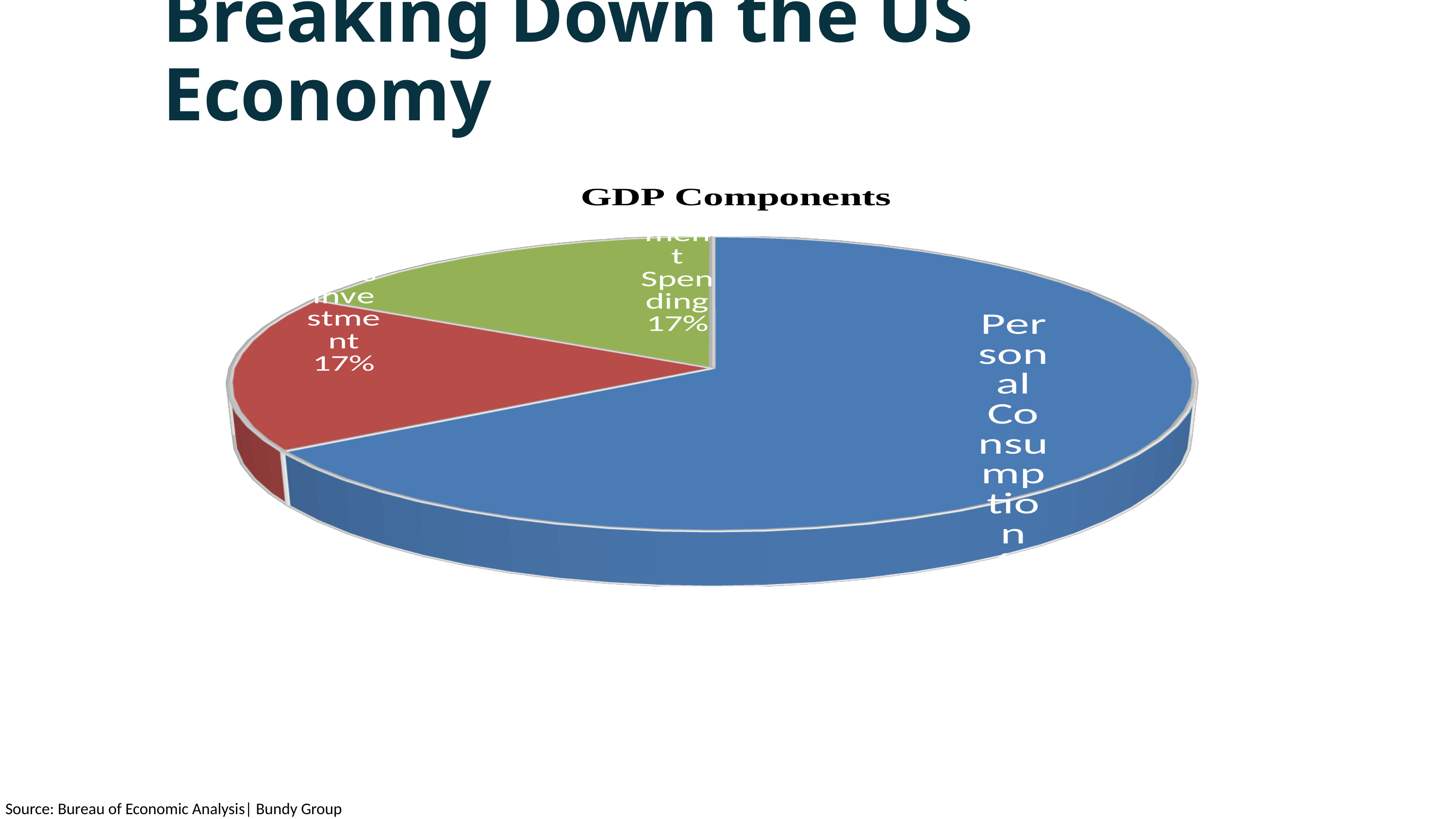
Which component has the largest slice in the GDP Components pie chart? Personal Consumption What kind of chart is shown on the slide? pie chart What is the title of the chart? GDP Components What colour is the Personal Consumption slice? blue What share of the pie does the green Spending slice account for? 17% How many slices does the GDP Components pie chart have? 3 What share of the pie does Investment account for? 17% Which is larger, the Personal Consumption slice or the Investment slice? Personal Consumption What is the difference between the Investment share and the Spending share? 0% Which slice is smaller, Personal Consumption or the green Spending slice? Spending